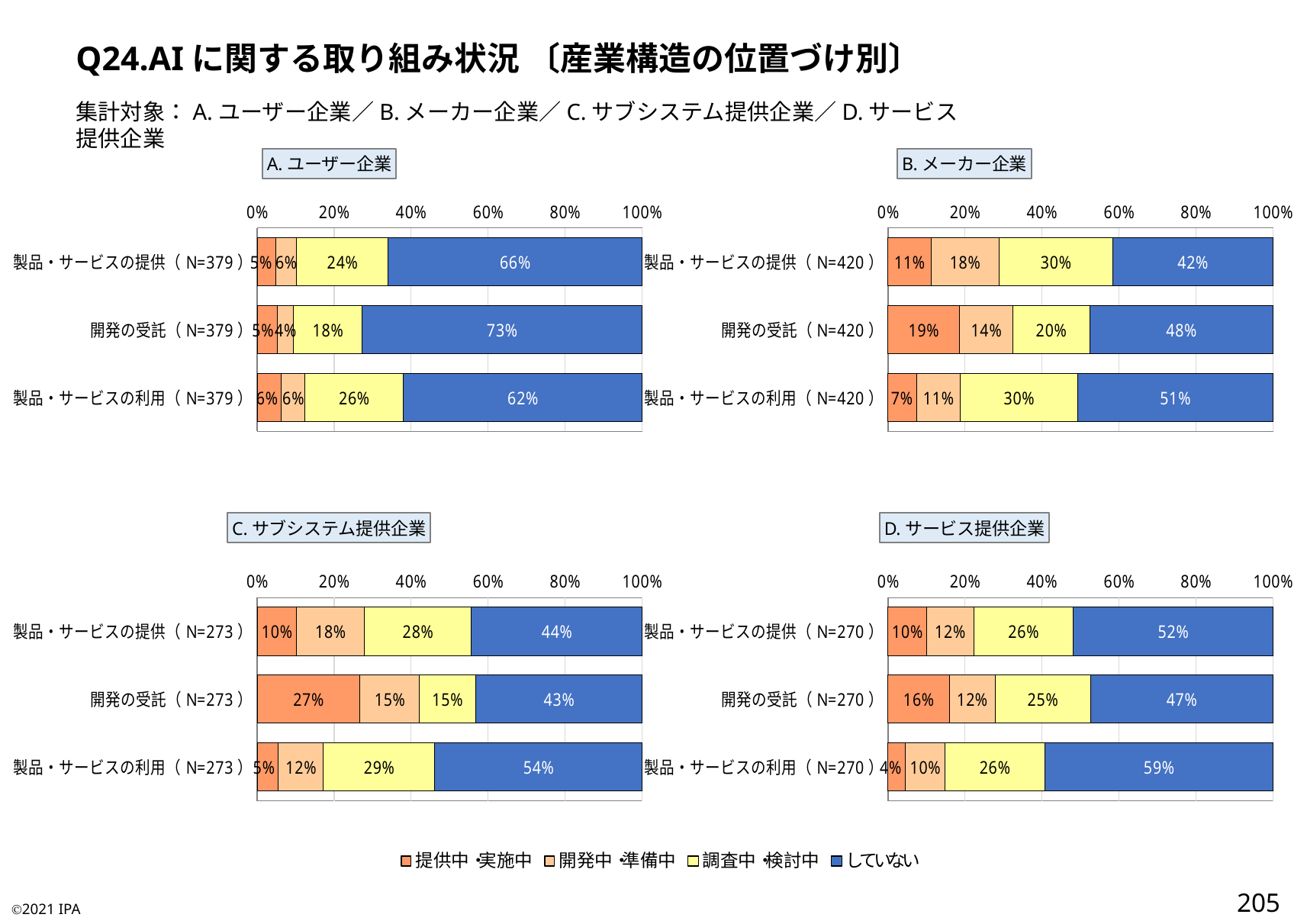
In the chart titled A. ユーザー企業, which is larger: the 調査中・検討中 value for 製品・サービスの提供 (N=379) or for 製品・サービスの利用 (N=379)? 製品・サービスの利用 (N=379) In the chart titled D. サービス提供企業, what is the difference between the していない values for 製品・サービスの利用 (N=270) and 開発の受託 (N=270)? 12% In the chart titled C. サブシステム提供企業, which category has the highest value for 提供中・実施中? 開発の受託 (N=273) In the chart titled C. サブシステム提供企業, what is the value of 調査中・検討中 for 製品・サービスの利用 (N=273)? 29% In the chart titled B. メーカー企業, which category has the lowest value for していない? 製品・サービスの提供 (N=420) In the chart titled B. メーカー企業, what is the value of 提供中・実施中 for 開発の受託 (N=420)? 19% How many categories are shown in the chart titled D. サービス提供企業? 3 What kind of chart is the chart titled C. サブシステム提供企業? Stacked bar chart How many series does the legend list? 4 In the chart titled B. メーカー企業, is the していない value for 製品・サービスの利用 (N=420) greater or less than 40%? greater In the chart titled A. ユーザー企業, what is the value of していない for 開発の受託 (N=379)? 73% In the chart titled D. サービス提供企業, what is the value of 開発中・準備中 for 製品・サービスの提供 (N=270)? 12%